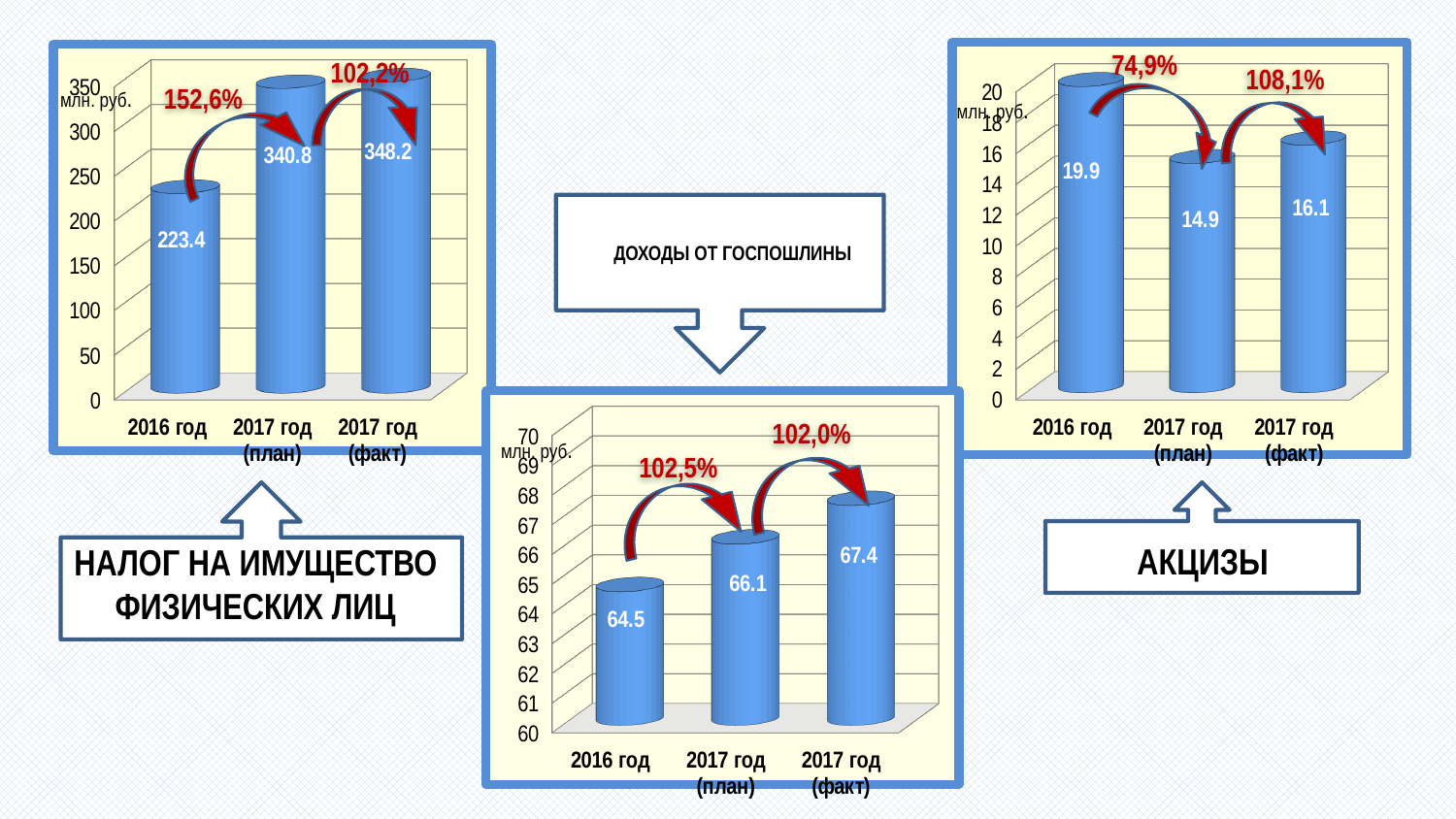
In the left chart (НАЛОГ НА ИМУЩЕСТВО ФИЗИЧЕСКИХ ЛИЦ), what is the value for 2016 год? 223.4 In the left chart (НАЛОГ НА ИМУЩЕСТВО ФИЗИЧЕСКИХ ЛИЦ), what is the value for 2017 год (факт)? 348.2 In the right chart (АКЦИЗЫ), which category has the highest value? 2016 год In the right chart (АКЦИЗЫ), what percentage is shown on the arrow from 2016 год to 2017 год (план)? 74,9% In the right chart (АКЦИЗЫ), what is the difference between 2017 год (факт) and 2017 год (план)? 1.2 In the left chart (НАЛОГ НА ИМУЩЕСТВО ФИЗИЧЕСКИХ ЛИЦ), which category has the lowest value? 2016 год In the middle chart (ДОХОДЫ ОТ ГОСПОШЛИНЫ), what is the value for 2017 год (план)? 66.1 How many bars does the middle chart (ДОХОДЫ ОТ ГОСПОШЛИНЫ) have? 3 In the left chart (НАЛОГ НА ИМУЩЕСТВО ФИЗИЧЕСКИХ ЛИЦ), what is the difference between 2017 год (план) and 2016 год? 117.4 In the right chart (АКЦИЗЫ), what is the value for 2017 год (план)? 14.9 In the middle chart (ДОХОДЫ ОТ ГОСПОШЛИНЫ), which category has the highest value? 2017 год (факт) In the middle chart (ДОХОДЫ ОТ ГОСПОШЛИНЫ), do the values rise or fall from 2016 год to 2017 год (факт)? rise